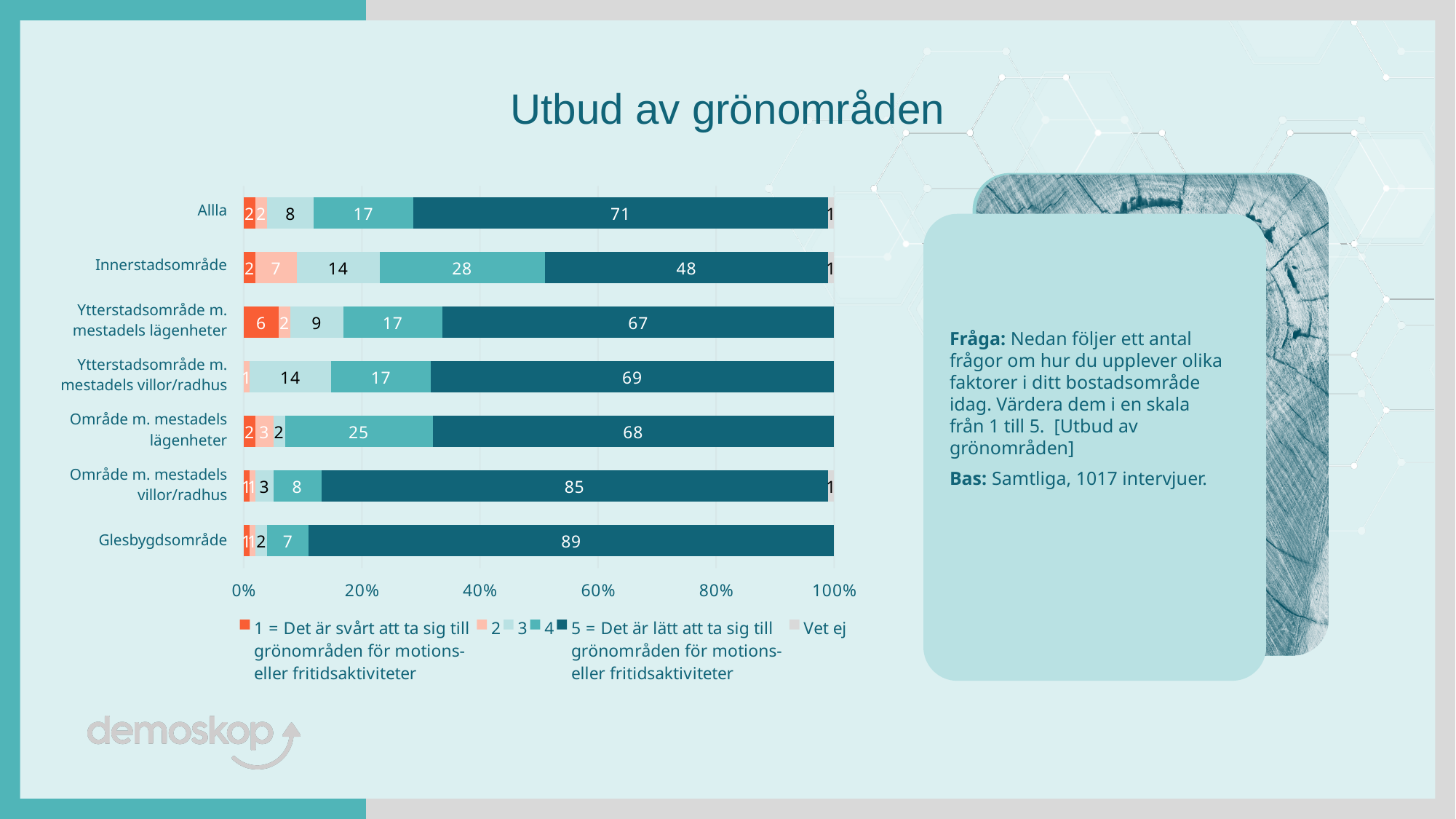
Which has a larger series 4 value, Innerstadsområde or Område m. mestadels lägenheter? Innerstadsområde What is the title of the chart? Utbud av grönområden What kind of chart is shown on the slide? stacked bar chart How many categories (rows) does the chart show? 7 What is the value of series 1 (Det är svårt att ta sig till grönområden) for Ytterstadsområde m. mestadels lägenheter? 6 How many series does the legend list? 6 Which category has the lowest value for series 5 (Det är lätt att ta sig till grönområden)? Innerstadsområde What is the value of series 4 for Innerstadsområde? 28 What is the value of series 5 (Det är lätt att ta sig till grönområden) for Glesbygdsområde? 89 What is the value of series 3 for Ytterstadsområde m. mestadels villor/radhus? 14 Which category has the highest value for series 5 (Det är lätt att ta sig till grönområden)? Glesbygdsområde What is the difference between the series 5 values for Område m. mestadels villor/radhus and Allla? 14